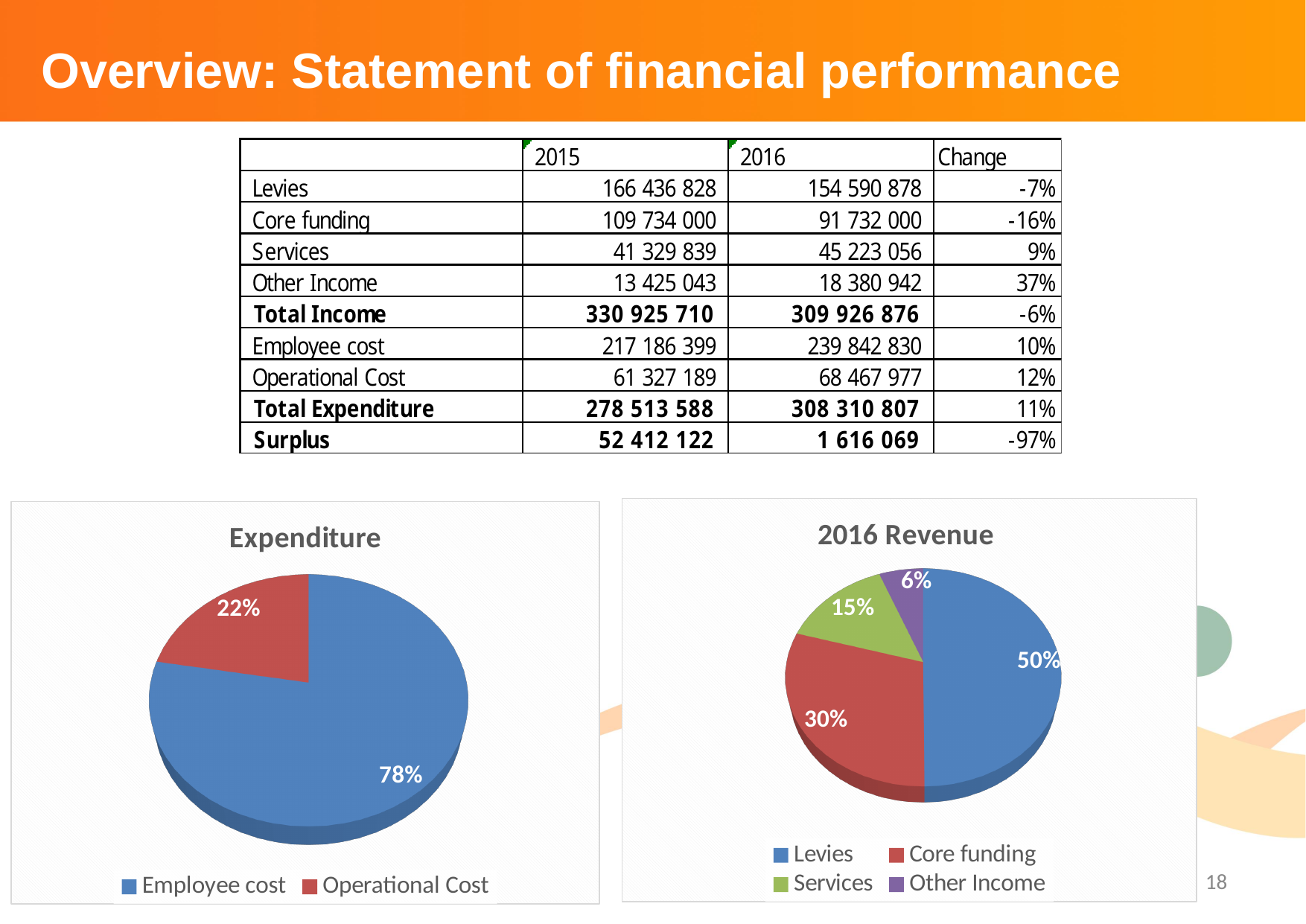
In the 2016 Revenue chart, what colour is the Services slice? Green In the Expenditure chart, what share of the pie is Operational Cost? 22% In the Expenditure chart, what share of the pie is Employee cost? 78% In the 2016 Revenue chart, which slice is larger, Services or Other Income? Services In the 2016 Revenue chart, which category has the smallest slice? Other Income In the 2016 Revenue chart, what share of the pie is Core funding? 30% In the Expenditure chart, which category has the largest slice? Employee cost In the Expenditure chart, what is the difference in percentage points between the Employee cost and Operational Cost slices? 56 How many slices does the 2016 Revenue chart have? 4 What kind of chart is the Expenditure chart? Pie chart How many categories does the Expenditure chart's legend list? 2